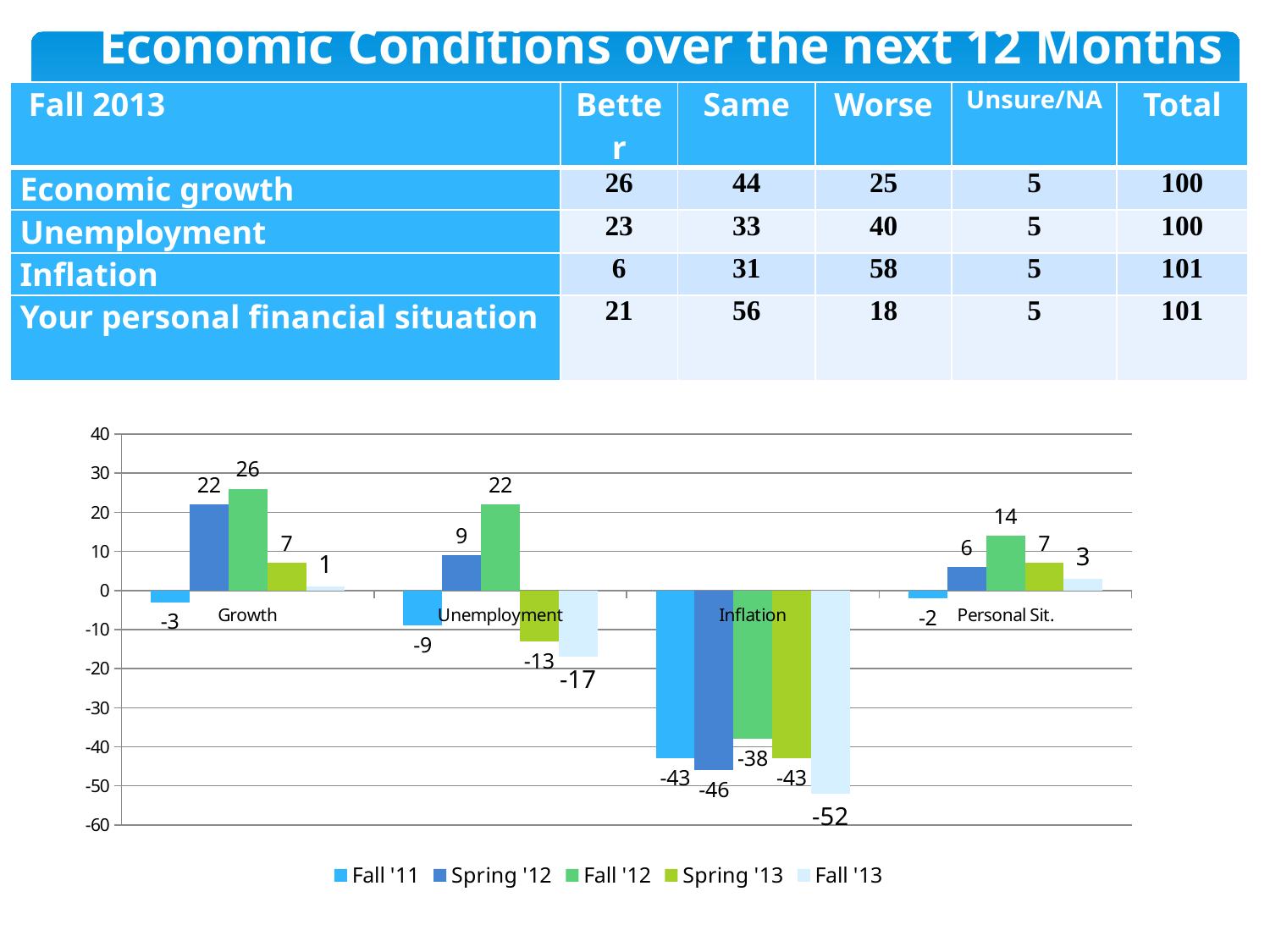
Which series is shown in the lightest blue colour in the chart legend? Fall '13 Which series has the lowest value in the Inflation category? Fall '13 What is the difference between the Fall '12 and Spring '13 values in the Growth category? 19 What kind of chart is shown on the slide? bar chart Which is larger in the Unemployment category, the Spring '12 value or the Fall '12 value? Fall '12 How many series does the chart legend list? 5 How many categories are shown on the x axis of the chart? 4 Which series has the highest value in the Personal Sit. category? Fall '12 What is the value for Fall '13 in the Inflation category? -52 What is the value for Spring '13 in the Unemployment category? -13 Across the five series, do the values in the Inflation category rise or fall from Fall '12 to Fall '13? fall What is the value for Fall '12 in the Growth category? 26